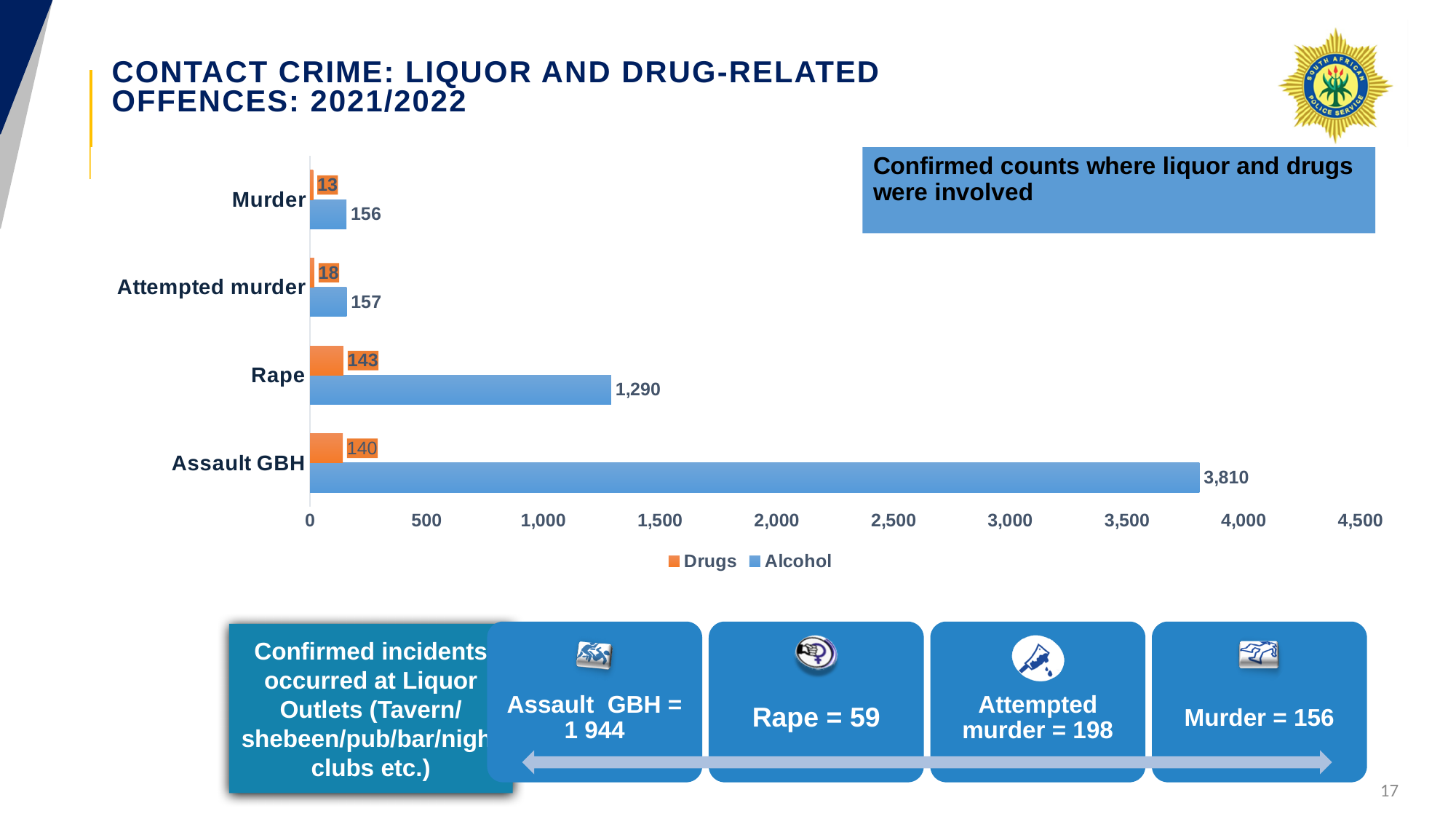
How many crime categories are shown on the chart? 4 What kind of chart is shown on the slide? Bar chart Which category has the lowest Drugs value? Murder What is the Drugs value for Rape? 143 Which is larger, the Drugs value for Rape or the Drugs value for Assault GBH? Rape Which category has the highest Alcohol value? Assault GBH What is the Drugs value for Murder? 13 What is the Alcohol value for Attempted murder? 157 How many series does the legend list? 2 What is the Alcohol value for Assault GBH? 3,810 What is the difference between the Alcohol values for Assault GBH and Rape? 2,520 Is the Alcohol value for Rape greater or less than 1,000? greater